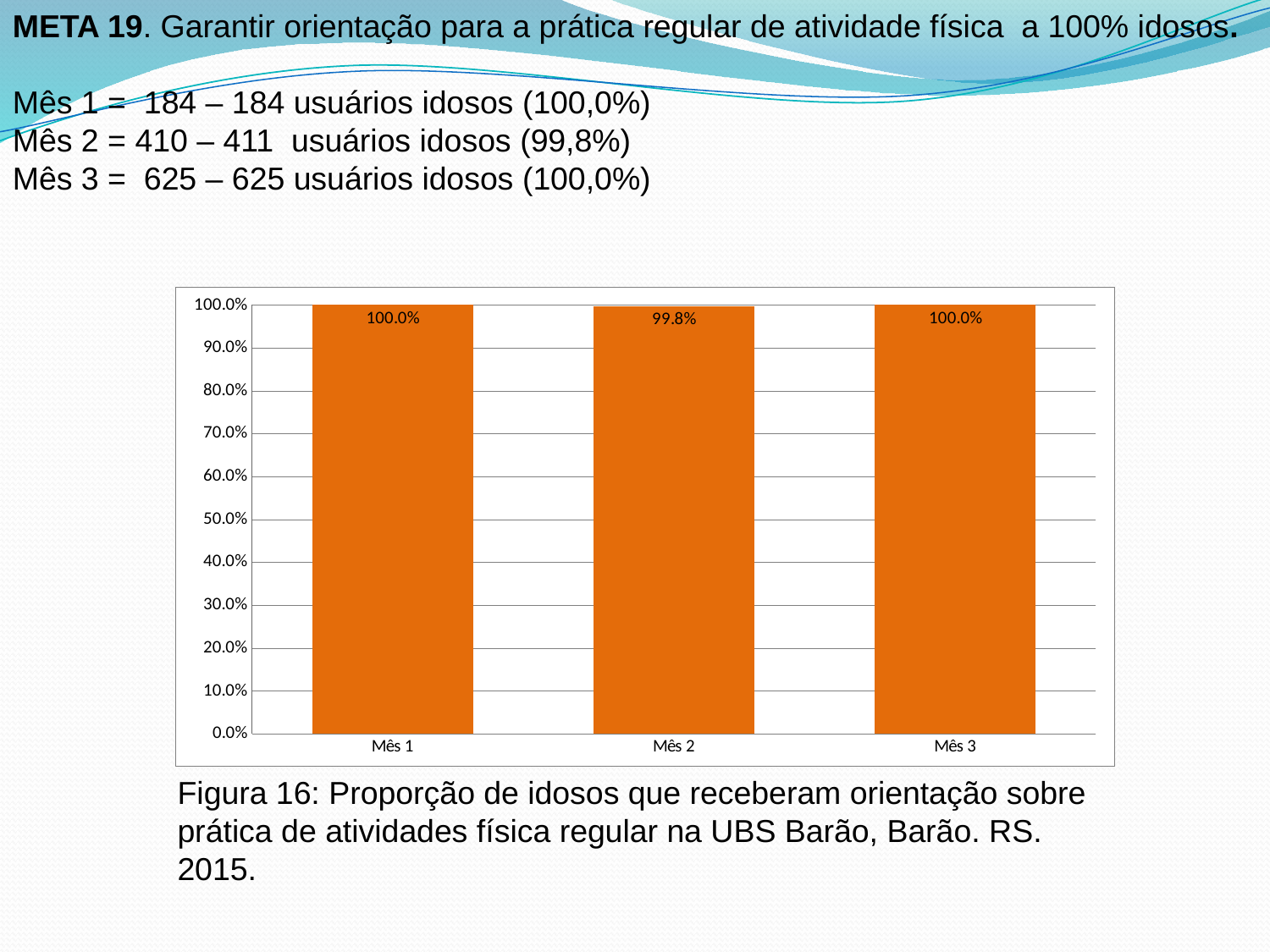
Is the value for Mês 3 greater or less than 50.0%? greater Is the value for Mês 2 greater or less than 90.0%? greater What kind of chart is shown on the slide? bar chart What is the value for Mês 1? 100.0% How many months are shown on the x axis? 3 What is the value for Mês 3? 100.0% What is the difference between the values for Mês 1 and Mês 2? 0.2% What figure number is given in the caption below the chart? Figura 16 What is the value for Mês 2? 99.8% Which month has the lowest value? Mês 2 What colour are the bars in the chart? orange